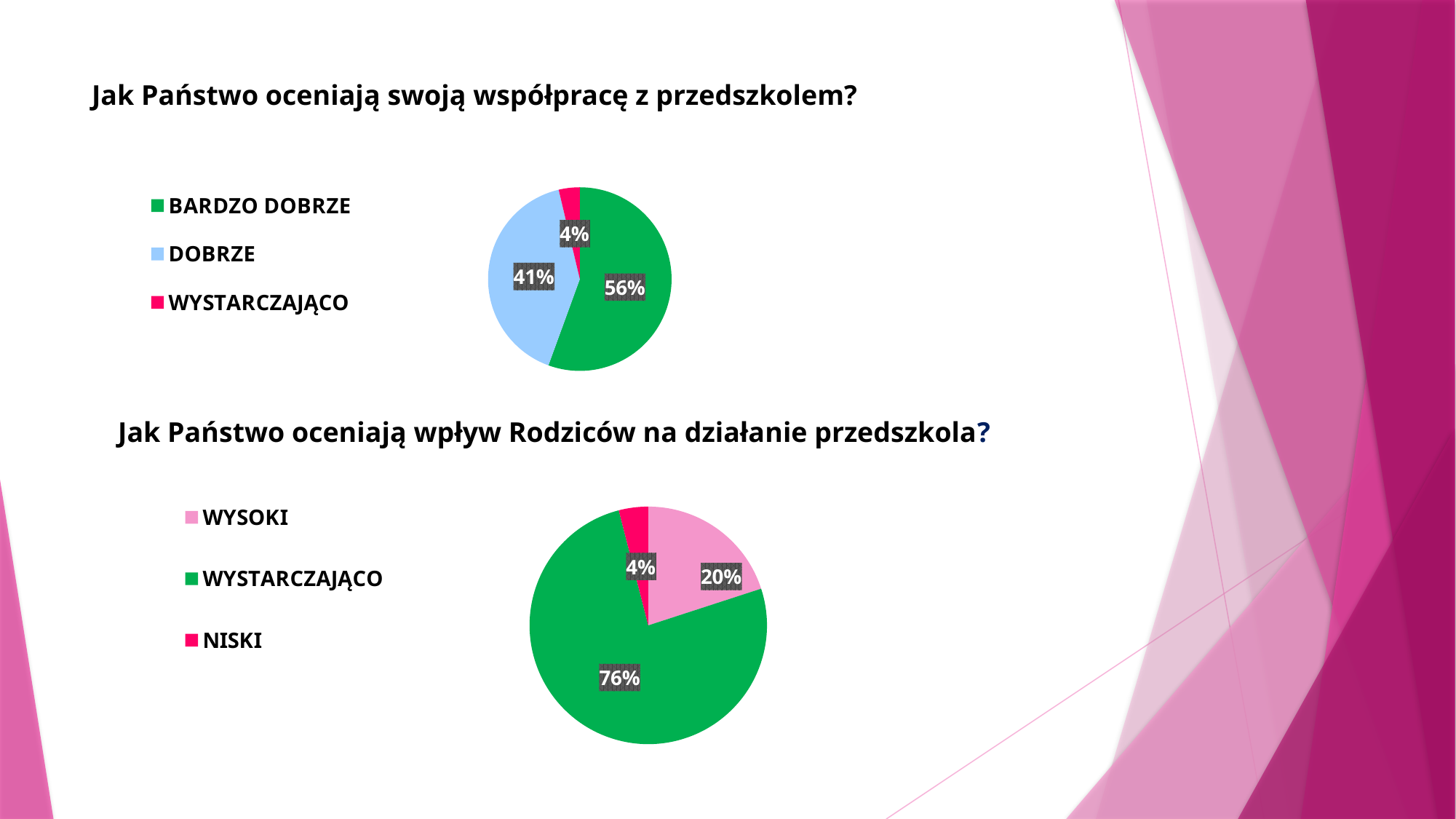
In the top pie chart (Jak Państwo oceniają swoją współpracę z przedszkolem?), what share is labelled for DOBRZE? 41% In the top pie chart (Jak Państwo oceniają swoją współpracę z przedszkolem?), what share is labelled for BARDZO DOBRZE? 56% In the bottom pie chart (Jak Państwo oceniają wpływ Rodziców na działanie przedszkola?), what share is labelled for WYSTARCZAJĄCO? 76% In the bottom pie chart (Jak Państwo oceniają wpływ Rodziców na działanie przedszkola?), which category has the largest slice? WYSTARCZAJĄCO In the top pie chart (Jak Państwo oceniają swoją współpracę z przedszkolem?), which category has the smallest slice? WYSTARCZAJĄCO In the bottom pie chart (Jak Państwo oceniają wpływ Rodziców na działanie przedszkola?), how many categories does the legend list? 3 In the top pie chart (Jak Państwo oceniają swoją współpracę z przedszkolem?), what share is labelled for WYSTARCZAJĄCO? 4% In the bottom pie chart (Jak Państwo oceniają wpływ Rodziców na działanie przedszkola?), what share is labelled for NISKI? 4% In the top pie chart (Jak Państwo oceniają swoją współpracę z przedszkolem?), which category has the largest slice? BARDZO DOBRZE In the top pie chart (Jak Państwo oceniają swoją współpracę z przedszkolem?), what is the difference in percentage points between BARDZO DOBRZE and DOBRZE? 15 percentage points In the bottom pie chart (Jak Państwo oceniają wpływ Rodziców na działanie przedszkola?), what share is labelled for WYSOKI? 20% What type of chart is used for both charts on the slide? Pie chart